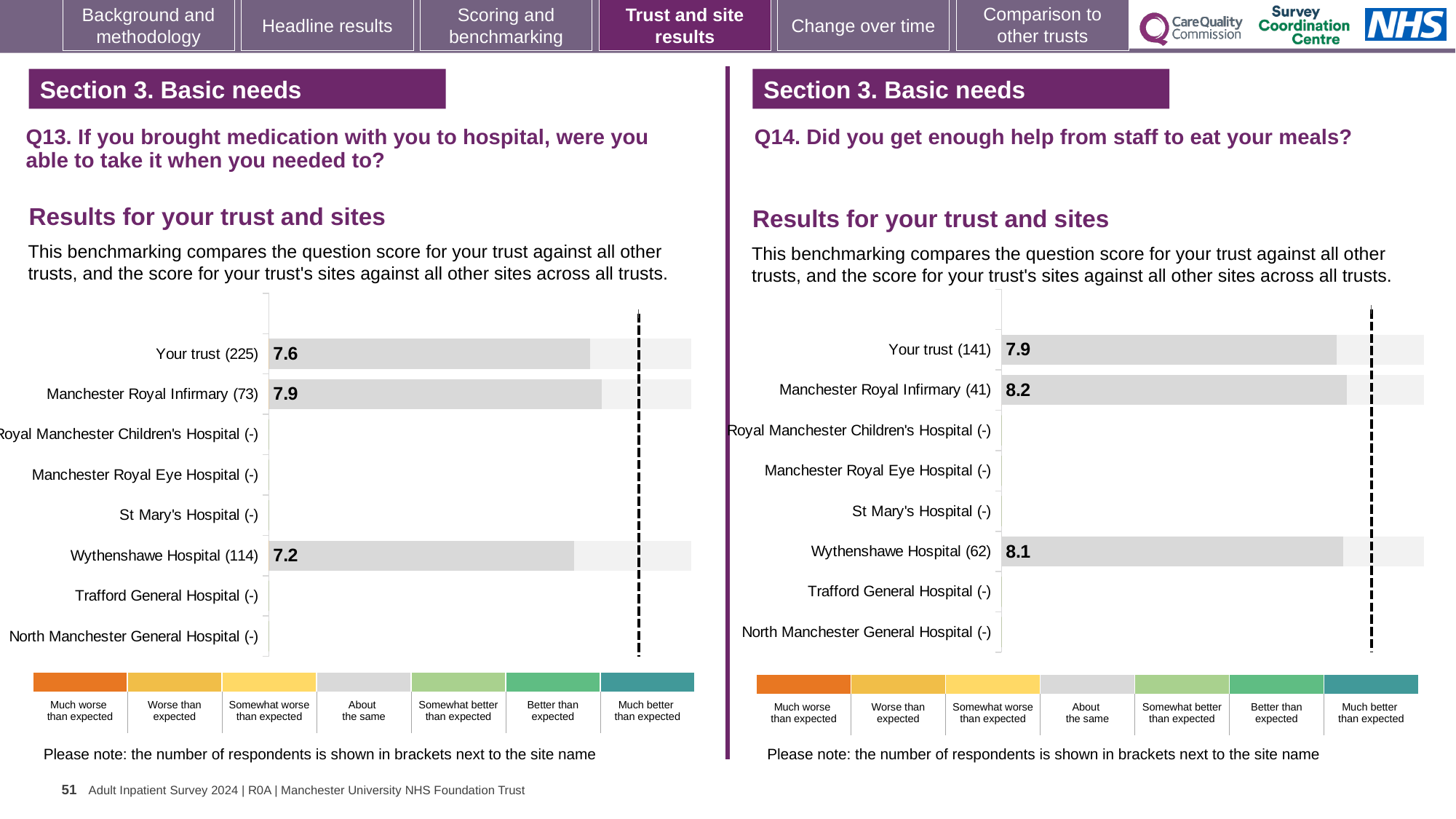
How many site/trust rows are listed on the y axis of the Q13 chart (left)? 8 In the Q14 chart (right), what is the score for Manchester Royal Infirmary (41)? 8.2 In the Q13 chart (left), what is the difference between the scores for Manchester Royal Infirmary (73) and Wythenshawe Hospital (114)? 0.7 In the Q13 chart (left), what is the score for Manchester Royal Infirmary (73)? 7.9 In the Q13 chart (left), what is the score for Wythenshawe Hospital (114)? 7.2 In the Q14 chart (right), what is the score for Wythenshawe Hospital (62)? 8.1 In the Q14 chart (right), what is the difference between the scores for Manchester Royal Infirmary (41) and Your trust (141)? 0.3 In the Q14 chart (right), what is the score for Your trust (141)? 7.9 In the Q14 chart (right), which row has the highest plotted score? Manchester Royal Infirmary (41) In the Q13 chart (left), what is the score for Your trust (225)? 7.6 In the Q13 chart (left), which site with a plotted score has the lowest value? Wythenshawe Hospital (114) What kind of chart is used for the Q14 results (right)? Bar chart